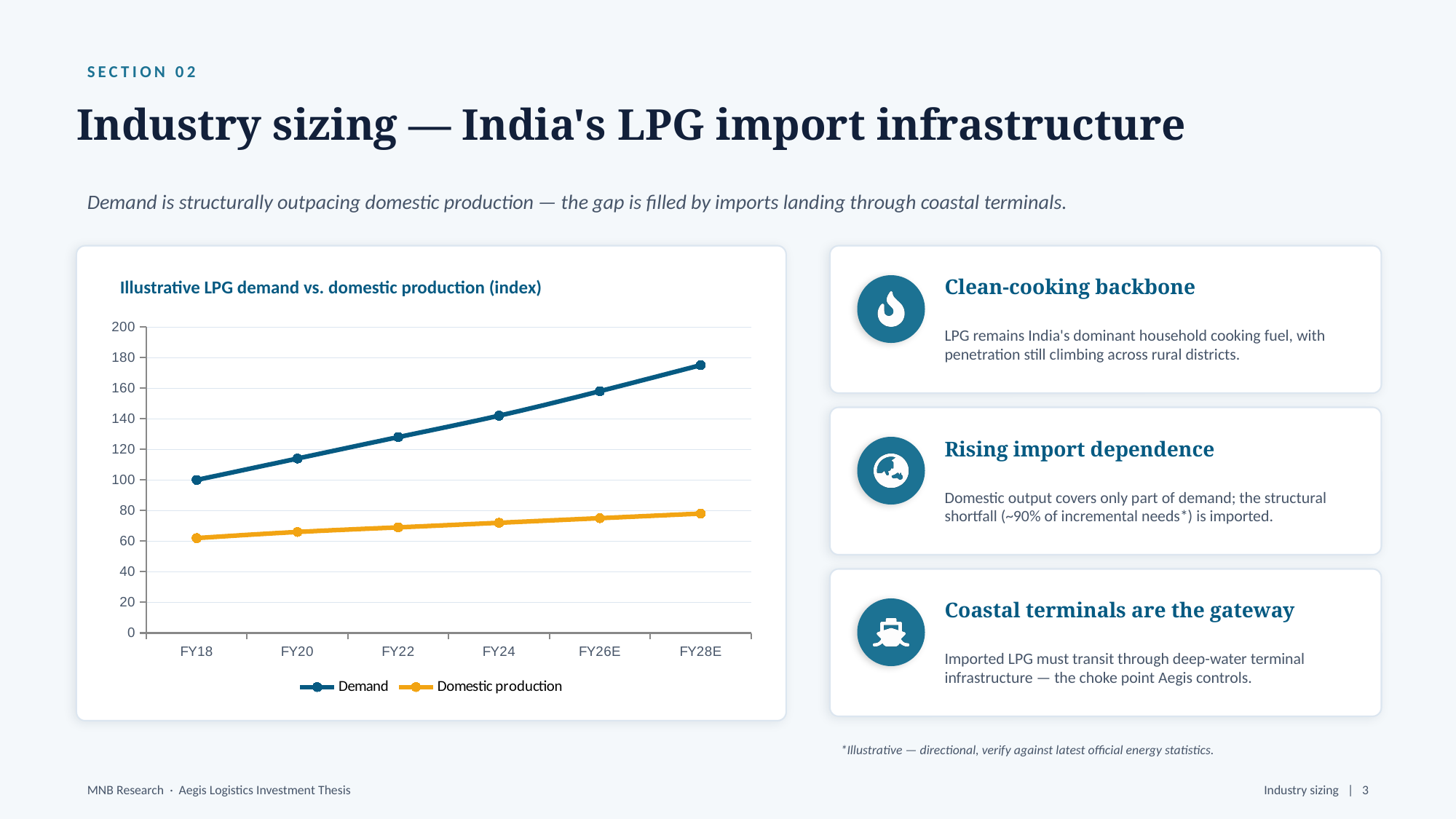
What kind of chart is shown on the slide? Line chart In which fiscal year is the Domestic production series at its lowest? FY18 At FY24, which series has the larger value, Demand or Domestic production? Demand In which fiscal year is the Demand series at its highest? FY28E Is the Domestic production value for FY18 greater or less than 80? less Is the Demand value for FY22 greater or less than 120? greater Is the Demand value for FY28E greater or less than 160? greater What is the Demand index value for FY18? 100 How many fiscal-year points are plotted along the x axis? 6 How many series does the chart legend list? 2 Does the Demand series rise or fall from FY18 to FY28E? Rise